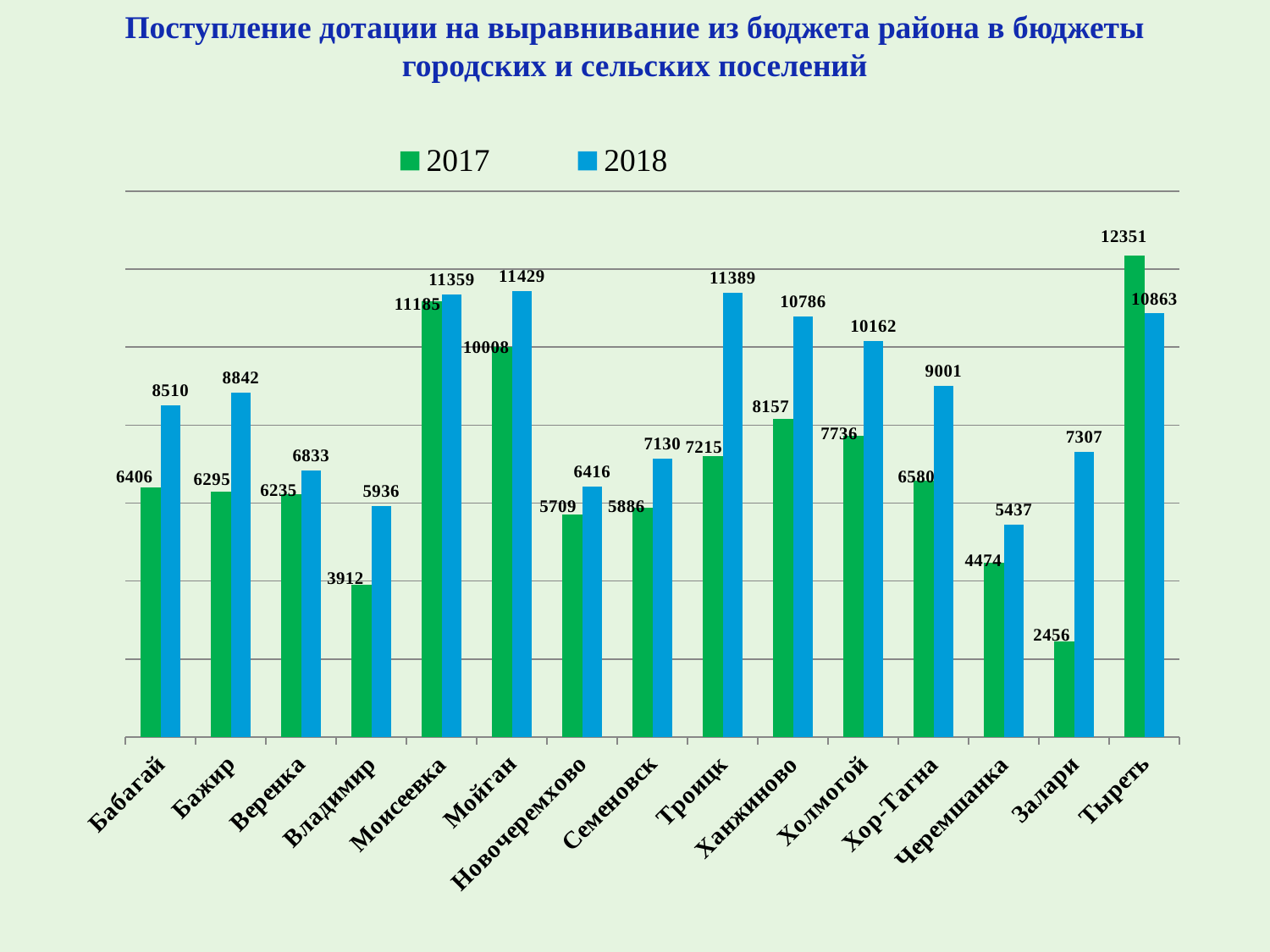
What is the 2017 value for Залари? 2456 How many settlements are shown on the x axis? 15 What kind of chart is shown on the slide? Bar chart Which settlement has the highest 2017 value? Тыреть What is the difference between the 2018 and 2017 values for Залари? 4851 Which settlement has the lowest 2018 value? Черемшанка Which is larger for Тыреть, the 2017 value or the 2018 value? 2017 What is the difference between the 2017 and 2018 values for Тыреть? 1488 What is the 2018 value for Хор-Тагна? 9001 What is the 2018 value for Троицк? 11389 How many series does the legend list? 2 Which settlement has the lowest 2017 value? Залари